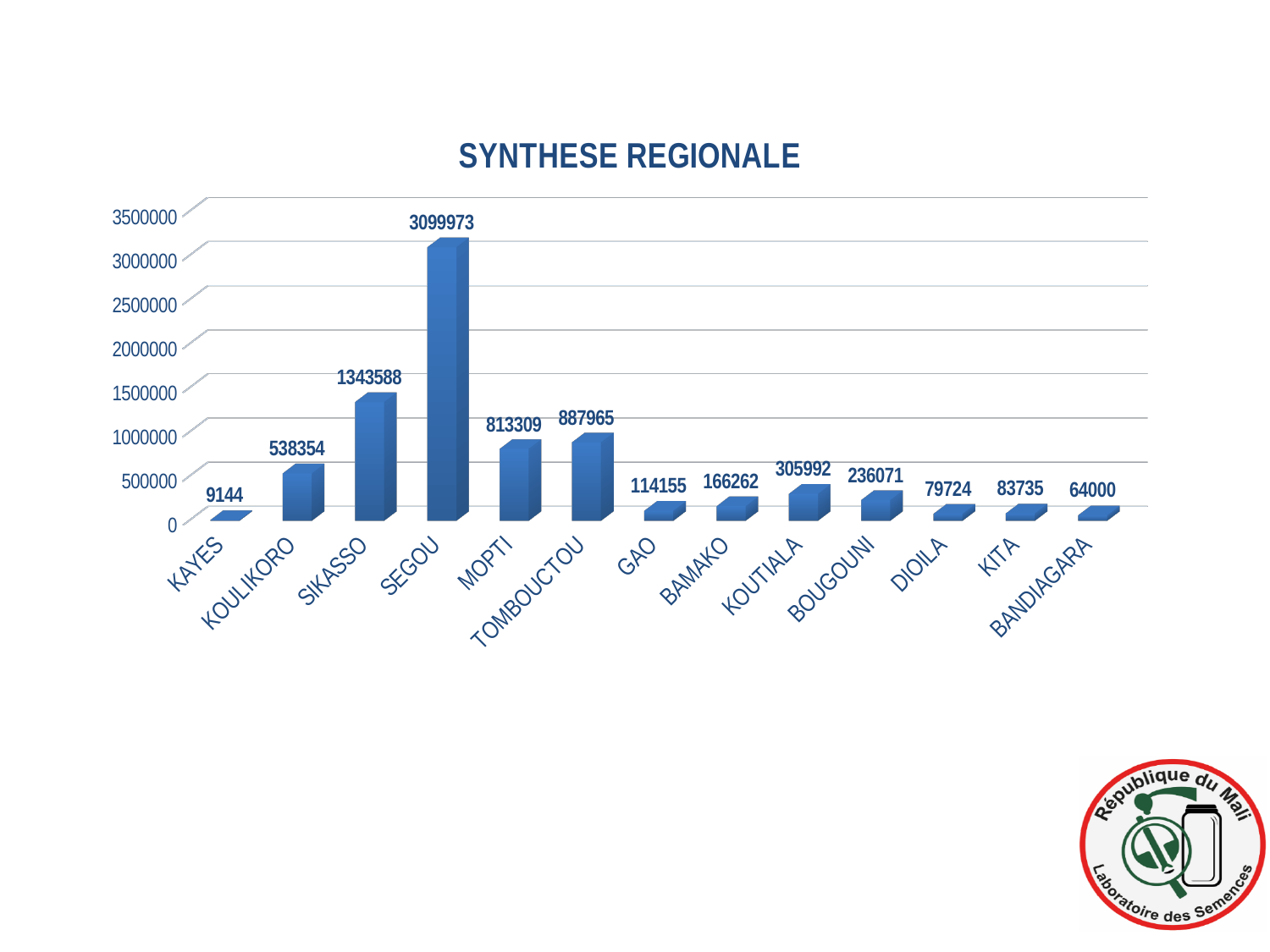
What kind of chart is shown on the slide? bar chart How many regions are shown on the chart? 13 What is the title of the chart? SYNTHESE REGIONALE What is the difference between the values for SEGOU and SIKASSO? 1756385 What is the value for SEGOU? 3099973 Which region has the lowest value? KAYES Which region has the highest value? SEGOU What is the value for BANDIAGARA? 64000 What is the value for TOMBOUCTOU? 887965 Is the value for SIKASSO greater or less than 1000000? greater Which is larger, the value for KOUTIALA or the value for BOUGOUNI? KOUTIALA What is the difference between the values for TOMBOUCTOU and MOPTI? 74656